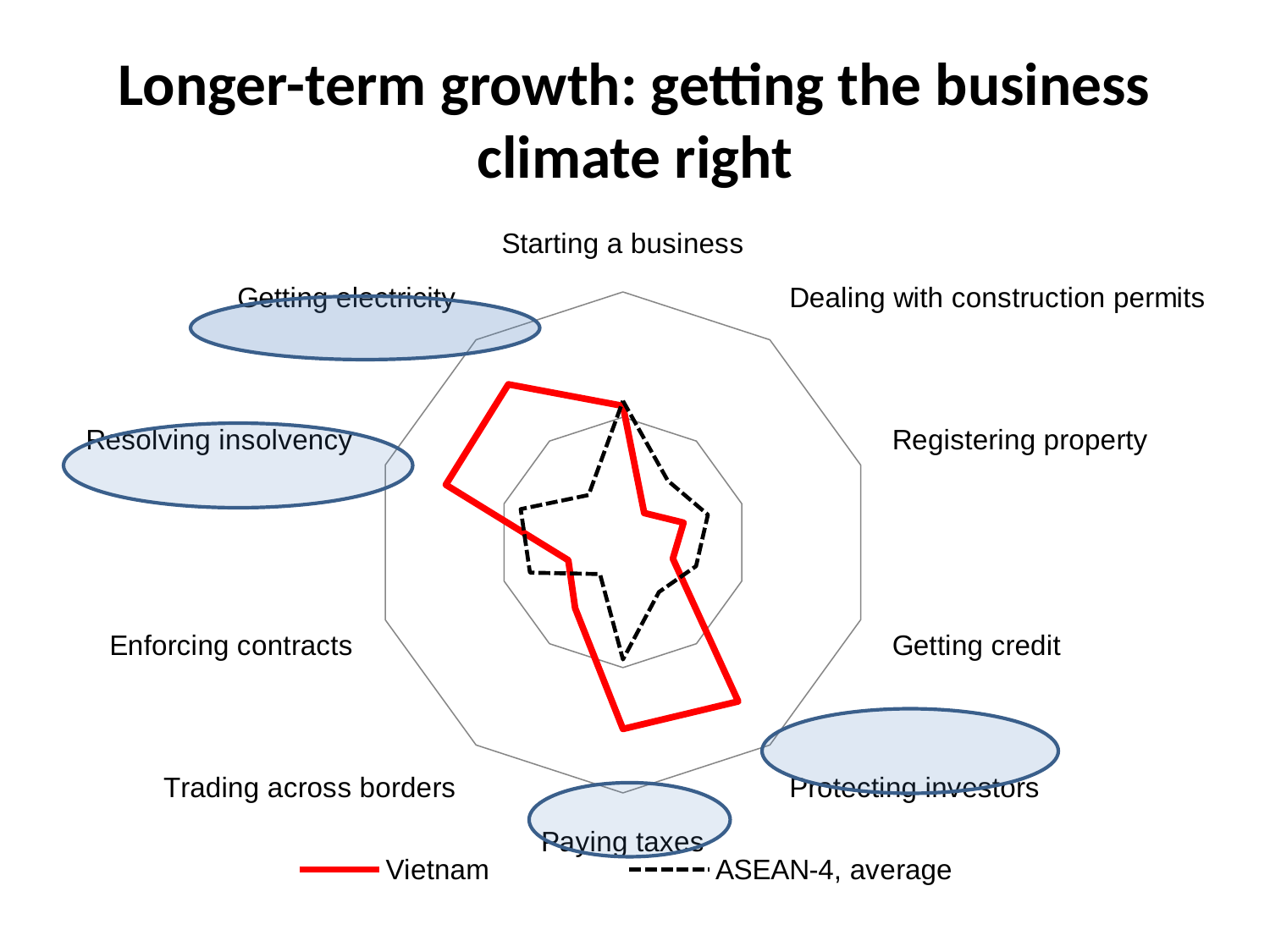
For Getting electricity, which series has the larger value, Vietnam or ASEAN-4, average? Vietnam Which series is drawn with a dashed line? ASEAN-4, average For Paying taxes, which series has the larger value, Vietnam or ASEAN-4, average? Vietnam Which two series are listed in the legend? Vietnam and ASEAN-4, average For Registering property, which series has the larger value, Vietnam or ASEAN-4, average? ASEAN-4, average How many categories (axes) does the radar chart have? 10 How many series does the legend list? 2 What kind of chart is shown on the slide? Radar chart